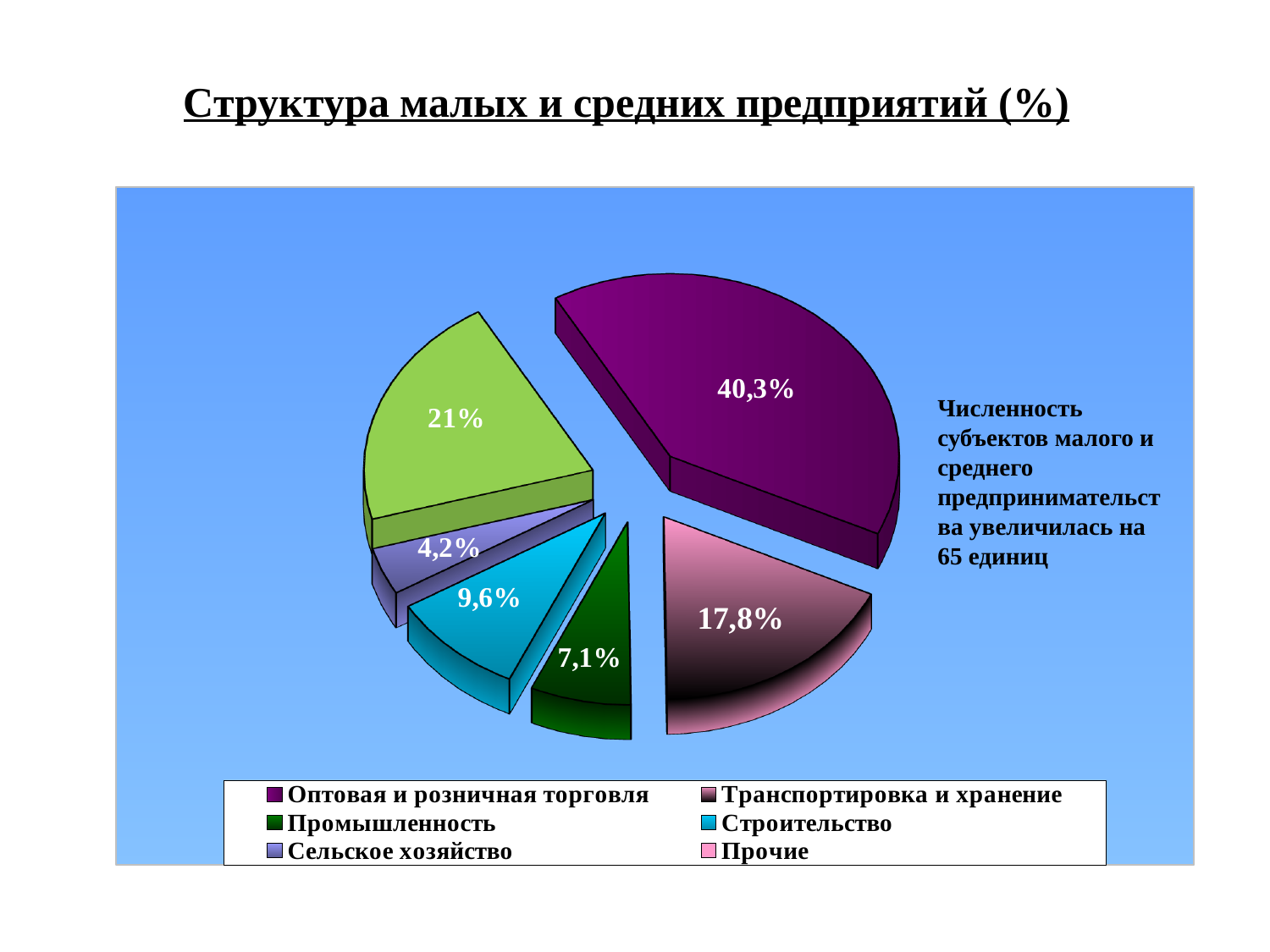
What is the difference in percentage points between Строительство and Промышленность? 2,5 Which category has the largest share of the pie? Оптовая и розничная торговля What percentage is shown for Строительство? 9,6% How many slices does the pie chart have? 6 Which is larger, the share for Строительство or the share for Промышленность? Строительство How many entries does the legend list? 6 What kind of chart is shown on the slide? pie chart What percentage is shown for Сельское хозяйство? 4,2% What is the difference in percentage points between the largest slice (40,3%) and the light green slice (21%)? 19,3 What percentage is shown for Промышленность? 7,1% What percentage is shown for Оптовая и розничная торговля? 40,3% Which category has the smallest share of the pie? Сельское хозяйство